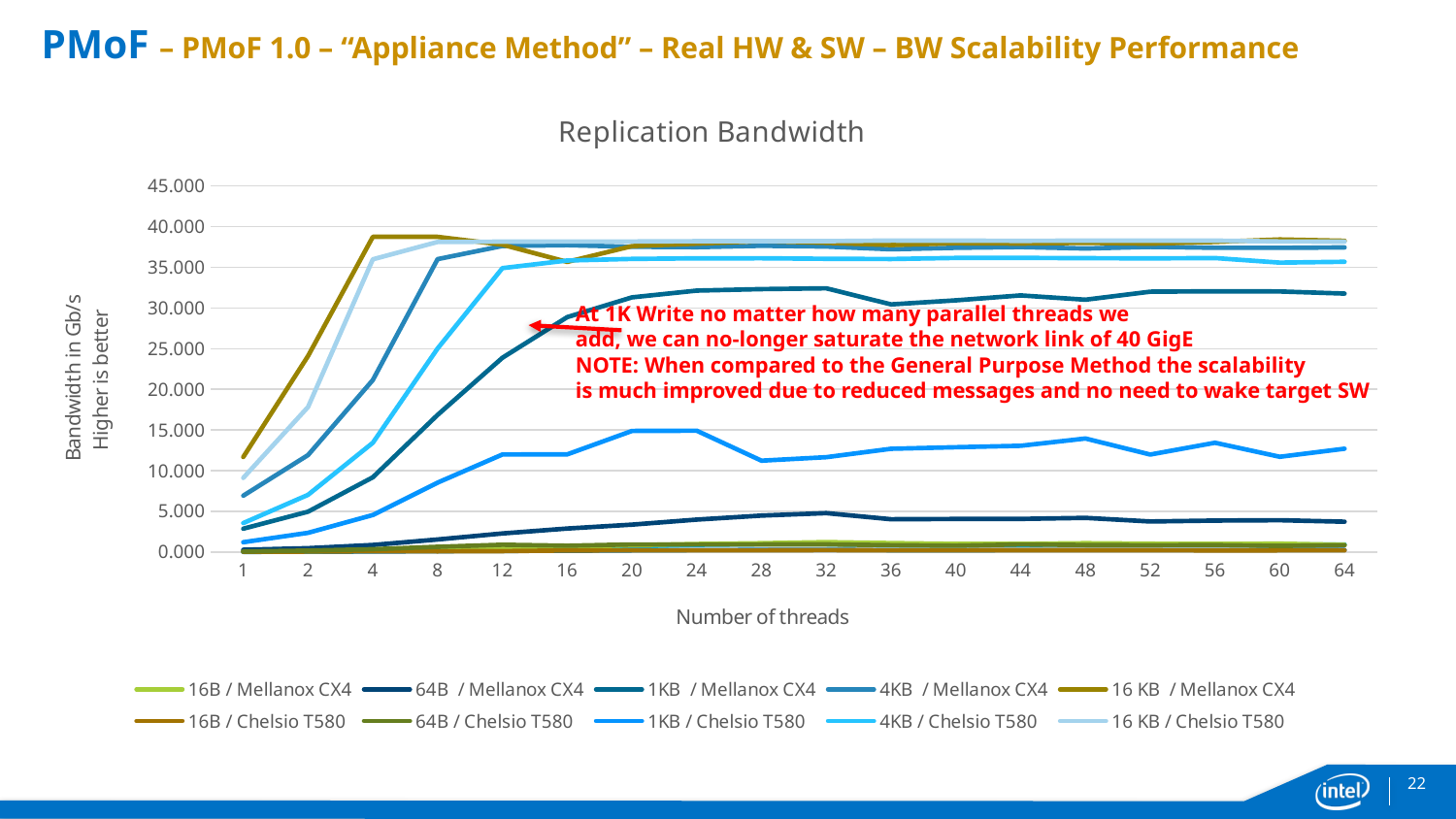
What is the label of the x axis? Number of threads Is the value for 16B / Mellanox CX4 at 64 threads greater or less than 5.000? less What is the title of the chart? Replication Bandwidth Is the value for 16 KB / Mellanox CX4 at 4 threads greater or less than 35.000? greater What kind of chart is shown on the slide? line chart At 1 thread, which is larger: 16 KB / Mellanox CX4 or 16B / Mellanox CX4? 16 KB / Mellanox CX4 How many thread-count points are shown along the x axis? 18 How many series does the chart legend list? 10 Is the value for 64B / Mellanox CX4 at 32 threads greater or less than 10.000? less Which series has the highest value at 4 threads? 16 KB / Mellanox CX4 Does the value for 16 KB / Mellanox CX4 rise or fall from 1 thread to 4 threads? rise